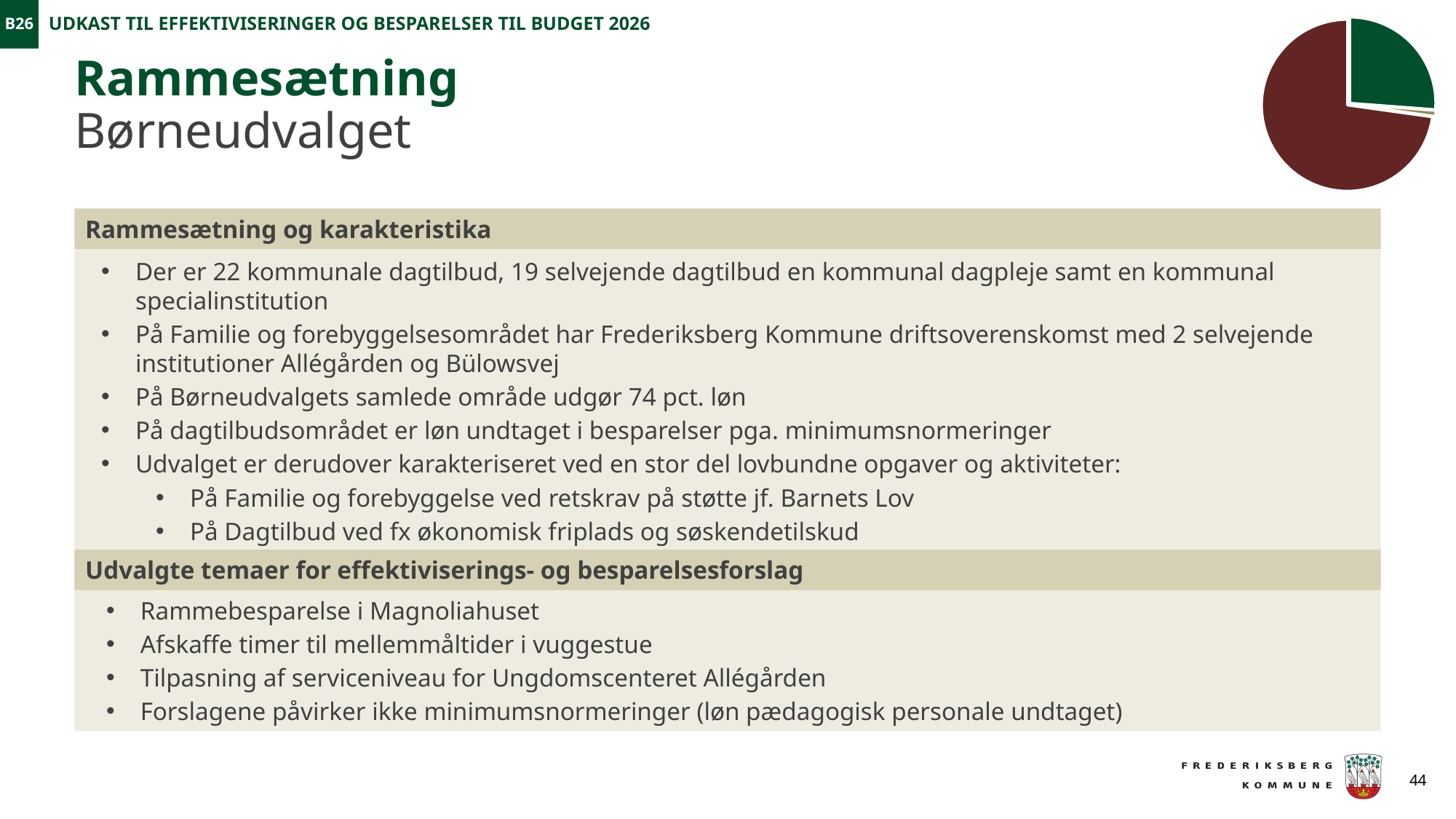
What kind of chart is shown in the top right corner of the slide? pie chart Does the pie chart in the top right corner show any data labels? No In the pie chart in the top right corner, which colour slice is the largest? dark red In the pie chart in the top right corner, does the dark green slice take up more or less than half of the pie? less Does the pie chart in the top right corner have a legend? No In the pie chart in the top right corner, does the dark red slice take up more or less than half of the pie? more In the pie chart in the top right corner, is the dark red slice or the dark green slice larger? dark red